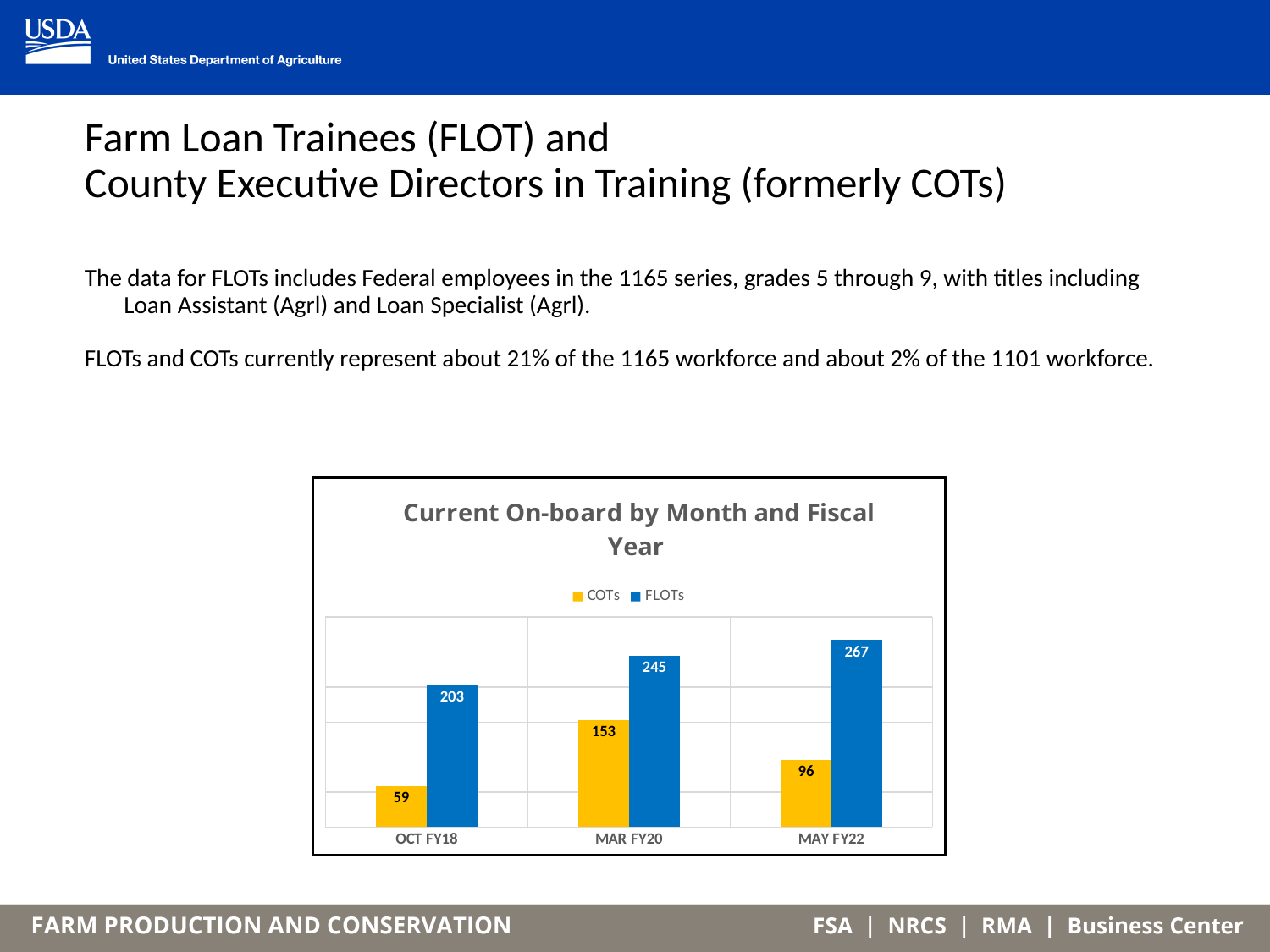
What is the difference between the FLOTs values in MAY FY22 and OCT FY18? 64 Which period has the highest FLOTs value? MAY FY22 Do the FLOTs values rise or fall from OCT FY18 to MAY FY22? rise What is the value for FLOTs in MAR FY20? 245 What kind of chart is shown? bar chart How many series does the legend list? 2 Which period has the lowest COTs value? OCT FY18 What is the value for COTs in OCT FY18? 59 Which is larger, the COTs value in MAR FY20 or the COTs value in MAY FY22? MAR FY20 What is the value for COTs in MAY FY22? 96 How many periods are shown on the x axis? 3 What is the difference between the FLOTs and COTs values in MAR FY20? 92